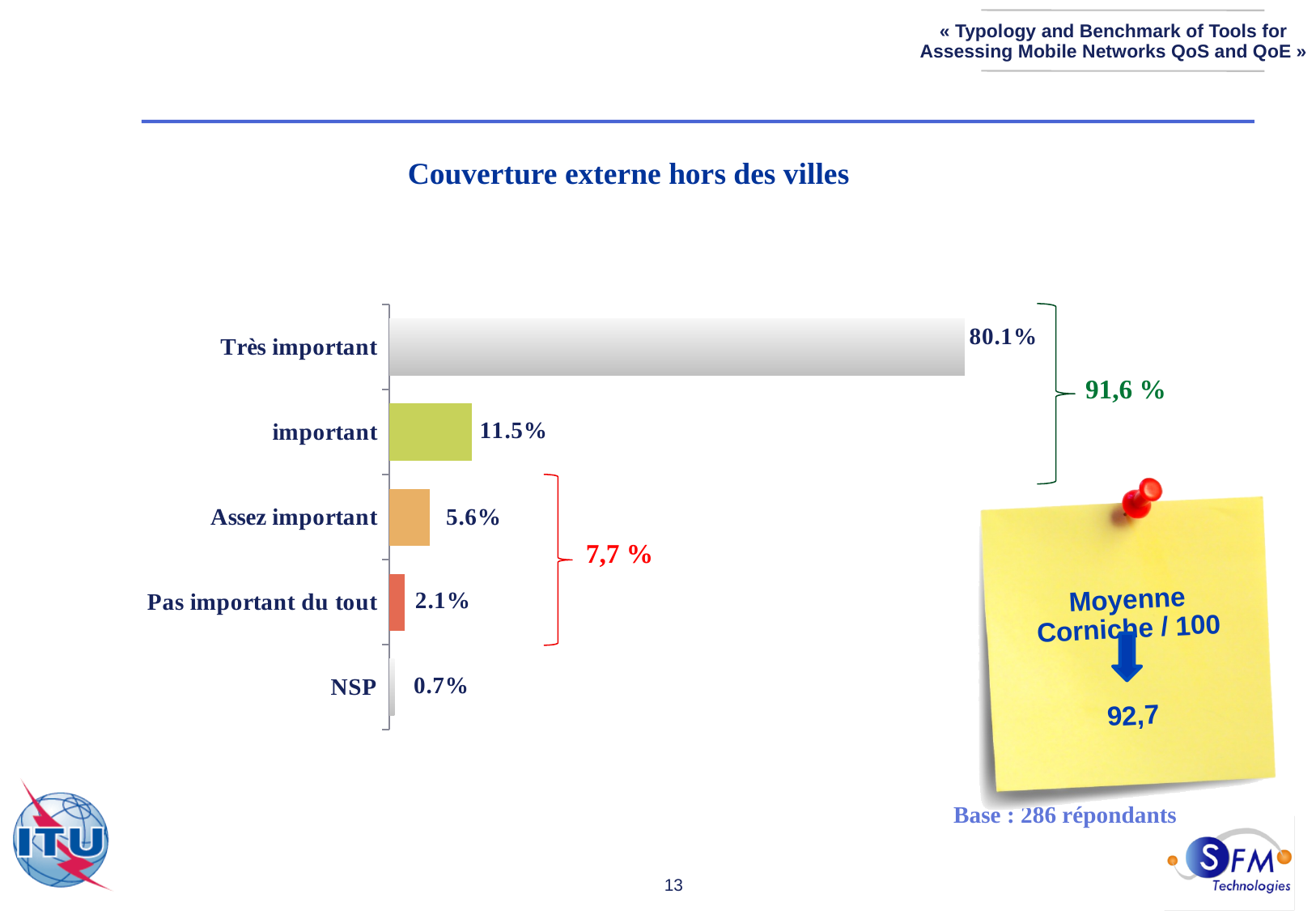
Which category has the highest value? Très important What is the value for "Très important"? 80.1% What kind of chart is shown on the slide? Bar chart What is the value for "Assez important"? 5.6% How many categories are shown in the chart? 5 What is the value for "important"? 11.5% What is the value for "Pas important du tout"? 2.1% Which category has the lowest value? NSP Which is larger, the value for "Assez important" or "Pas important du tout"? Assez important What is the title of the chart? Couverture externe hors des villes What is the difference between the values for "Très important" and "important"? 68.6% What is the value for "NSP"? 0.7%